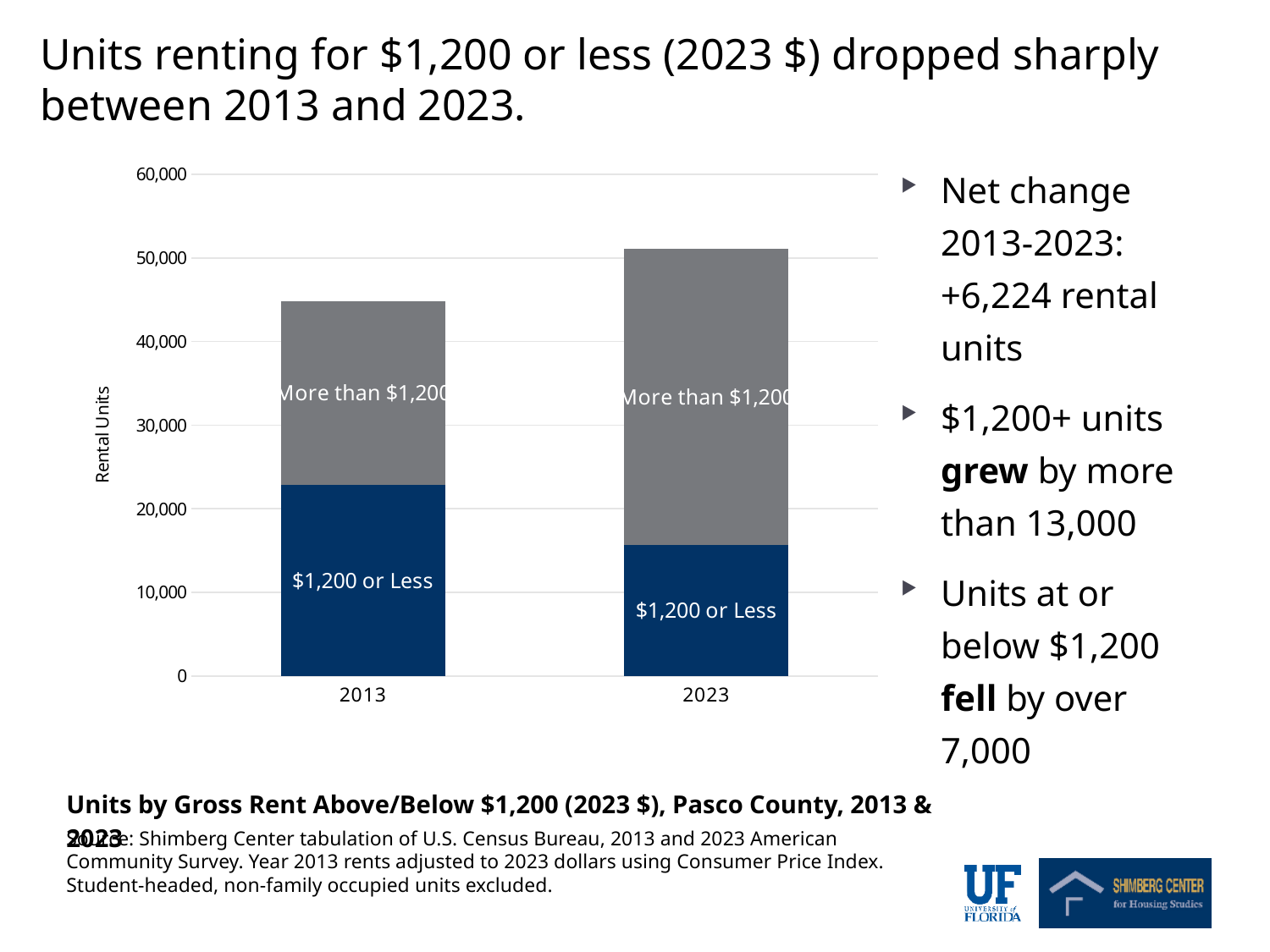
What are the two segment labels shown inside the bars? $1,200 or Less; More than $1,200 Is the total height of the 2023 bar greater or less than 40,000? greater Which year has the taller total bar, 2013 or 2023? 2023 Is the value for $1,200 or Less units in 2013 greater or less than 20,000? greater Is the value for $1,200 or Less units in 2023 greater or less than 20,000? less How many rent segments are stacked in each bar of the chart? 2 How many years (categories) are shown on the x axis of the chart? 2 What is the label on the vertical axis of the chart? Rental Units Does the $1,200 or Less segment rise or fall from 2013 to 2023? fall What kind of chart is shown on the slide? stacked bar chart Which year has more units renting for $1,200 or Less, 2013 or 2023? 2013